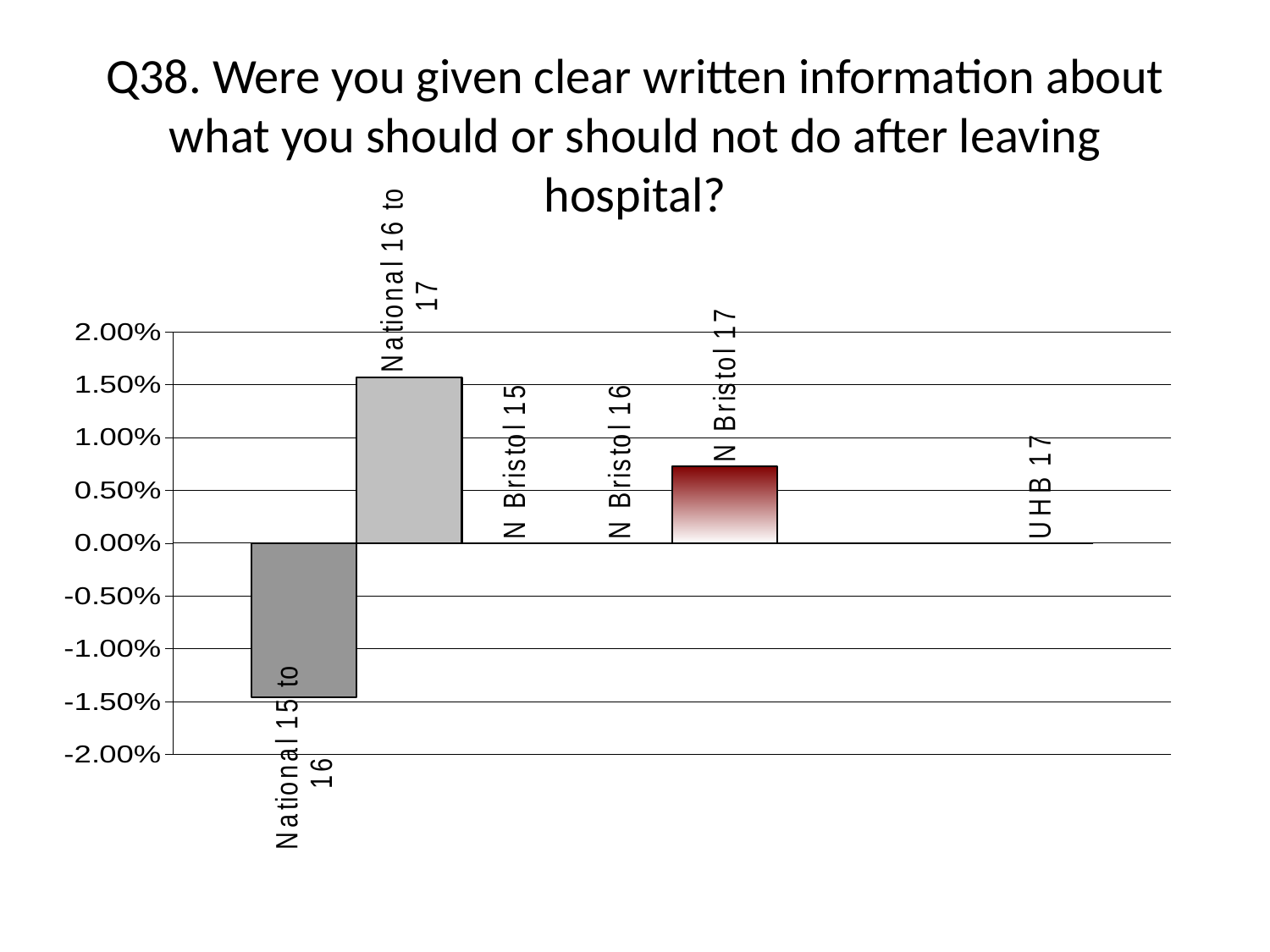
What is the question number given in the slide title? Q38 Which category has the lowest value in the chart? National 15 to 16 Which category has the highest value in the chart? National 16 to 17 How many categories are shown on the x axis of the chart? 6 What kind of chart is shown on the slide? Bar chart Which is larger, the value for N Bristol 17 or the value for National 15 to 16? N Bristol 17 Is the value for N Bristol 17 greater or less than 1.00%? less Which is larger, the value for National 16 to 17 or the value for N Bristol 17? National 16 to 17 Is the value for National 15 to 16 greater or less than -1.00%? less Is the value for National 16 to 17 greater or less than 1.00%? greater Which category is the only one with a negative value in the chart? National 15 to 16